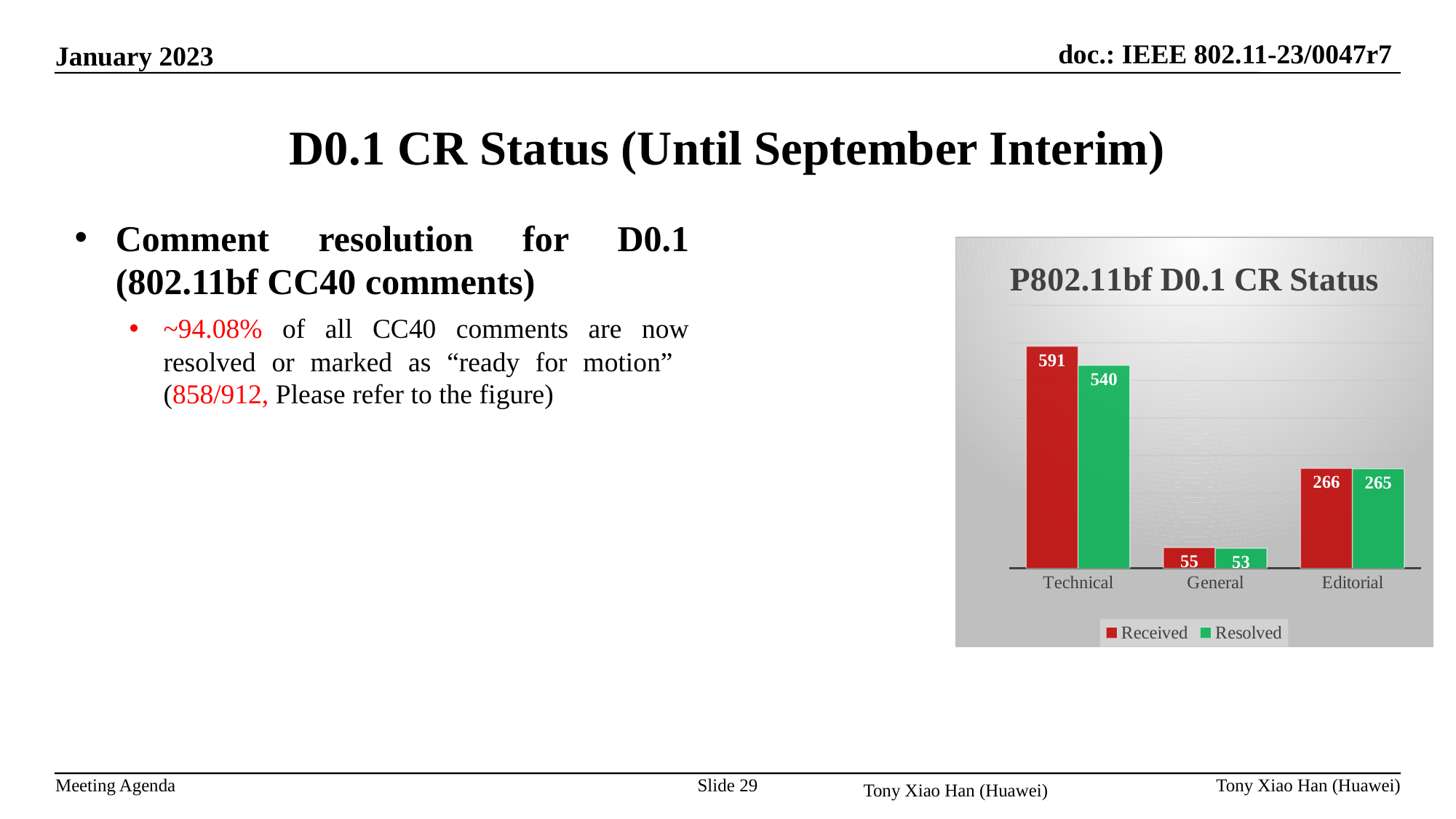
Which category has the highest Received value? Technical What is the Resolved value for General? 53 What is the title of the chart? P802.11bf D0.1 CR Status How many categories are shown on the x axis? 3 What kind of chart is shown? bar chart What is the difference between Received and Resolved for Technical? 51 Which category has the lowest Resolved value? General What is the Resolved value for Editorial? 265 What is the difference between the Received values for Editorial and General? 211 How many series does the legend list? 2 What is the Received value for Technical? 591 Which is larger, the Resolved value for Technical or the Resolved value for Editorial? Technical